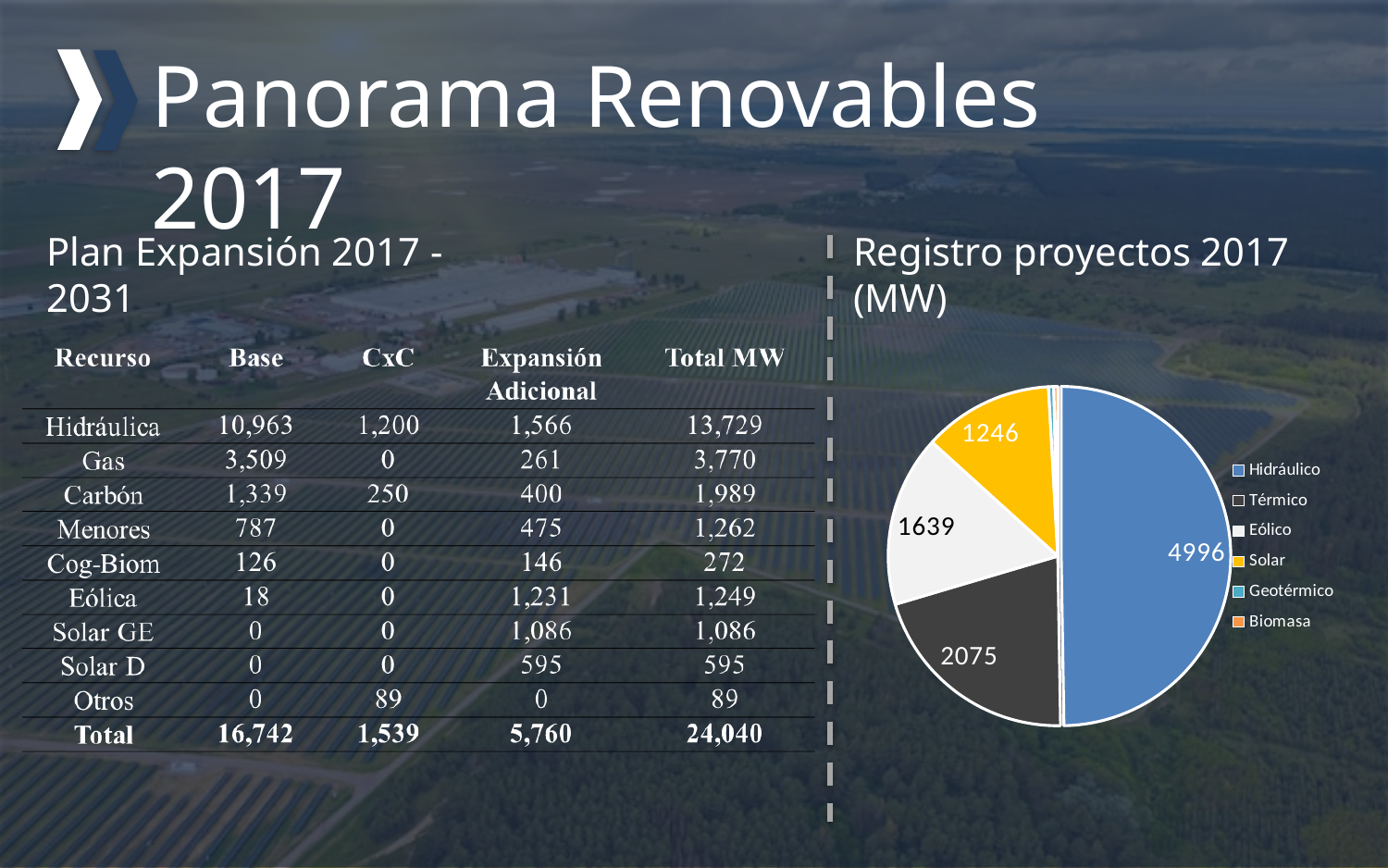
In the pie chart 'Registro proyectos 2017 (MW)', what colour is the Solar slice? yellow In the pie chart 'Registro proyectos 2017 (MW)', which is larger, Eólico or Térmico? Térmico How many categories does the legend of the pie chart 'Registro proyectos 2017 (MW)' list? 6 In the pie chart 'Registro proyectos 2017 (MW)', what is the difference between the Hidráulico and Eólico values? 3357 In the pie chart 'Registro proyectos 2017 (MW)', what is the value for Solar? 1246 What kind of chart is shown under the title 'Registro proyectos 2017 (MW)'? pie chart In the pie chart 'Registro proyectos 2017 (MW)', what is the difference between the Eólico and Térmico values? 436 In the pie chart 'Registro proyectos 2017 (MW)', what is the value for Térmico? 2075 In the pie chart 'Registro proyectos 2017 (MW)', what is the value for Eólico? 1639 In the pie chart 'Registro proyectos 2017 (MW)', which category has the largest slice? Hidráulico In the pie chart 'Registro proyectos 2017 (MW)', what is the value for Hidráulico? 4996 In the pie chart 'Registro proyectos 2017 (MW)', which is larger, Térmico or Solar? Térmico